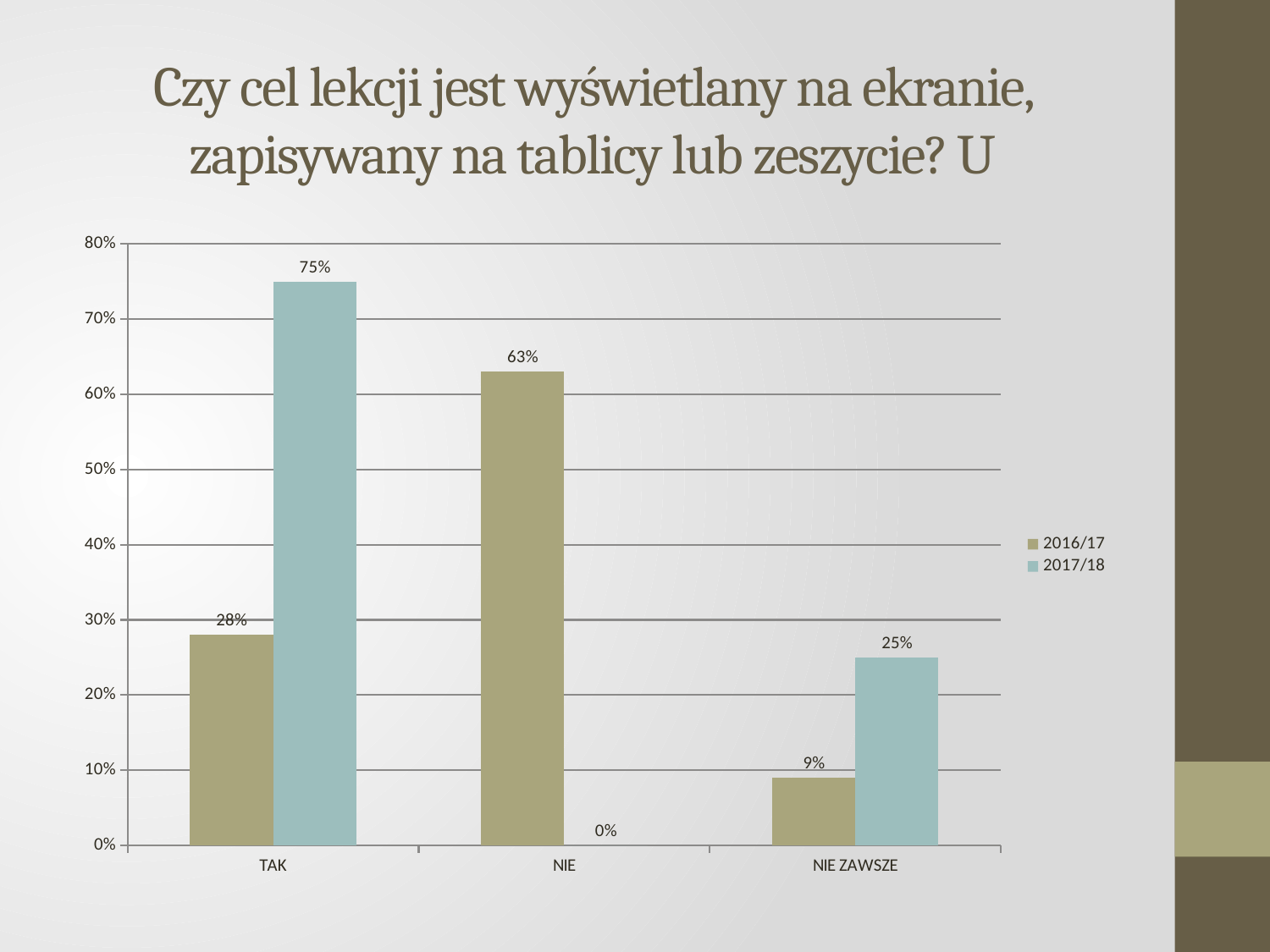
What is the value for TAK in the 2017/18 series? 75% What kind of chart is shown on the slide? Bar chart What is the value for NIE in the 2017/18 series? 0% What is the difference between the 2017/18 and 2016/17 values for TAK? 47% Which is larger for NIE ZAWSZE: the 2016/17 value or the 2017/18 value? 2017/18 Which category has the lowest value in the 2016/17 series? NIE ZAWSZE What is the value for NIE ZAWSZE in the 2017/18 series? 25% How many series does the legend list? 2 How many categories are shown on the x axis? 3 What is the value for NIE in the 2016/17 series? 63% Which category has the highest value in the 2017/18 series? TAK What is the value for TAK in the 2016/17 series? 28%